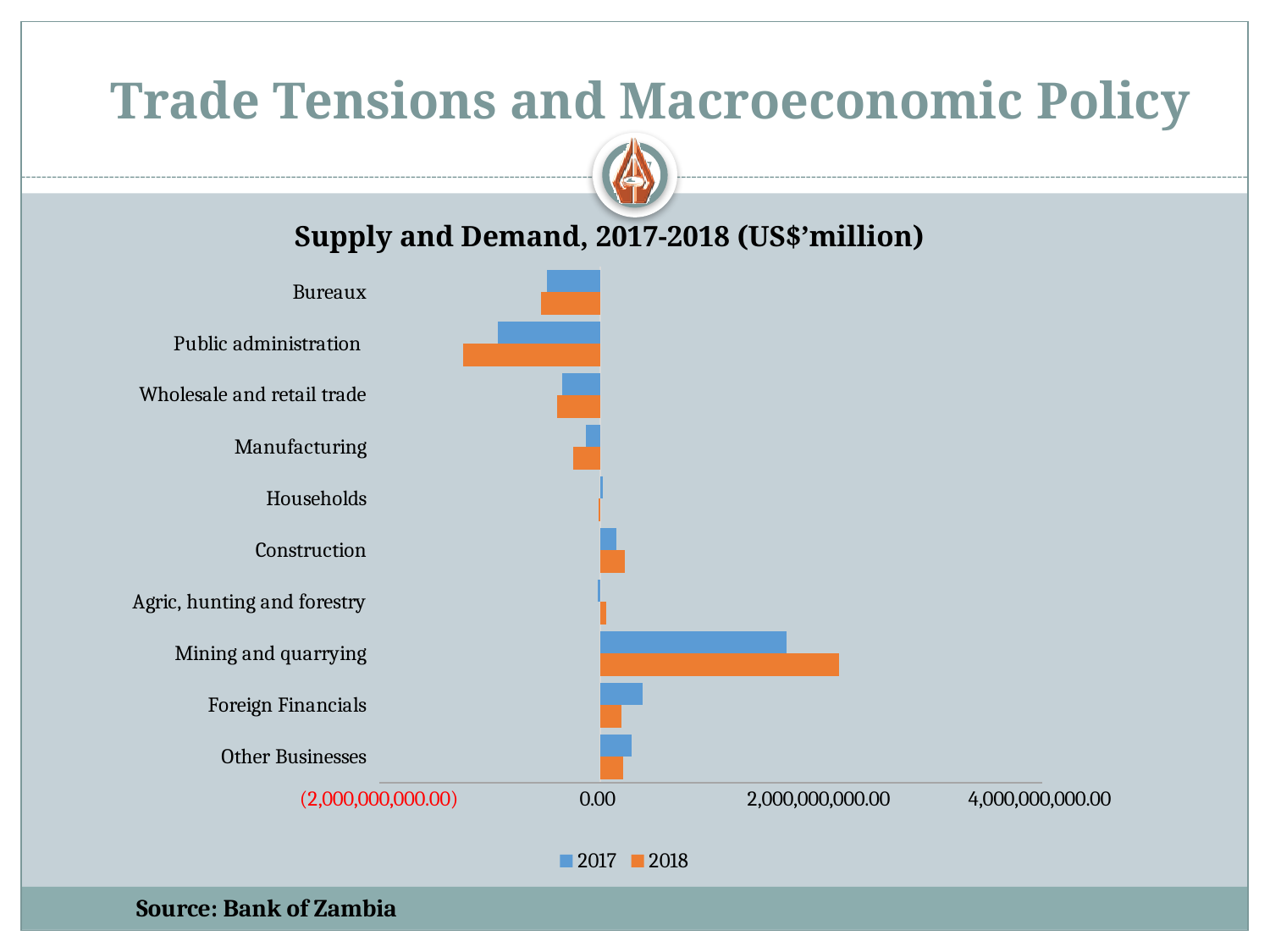
Is the 2018 value for Mining and quarrying greater or less than 2,000,000,000.00? greater What is the title of the chart? Supply and Demand, 2017-2018 (US$'million) How many categories are shown on the chart? 10 For Mining and quarrying, which year has the larger value, 2017 or 2018? 2018 Which category has the lowest (most negative) value for 2018? Public administration What kind of chart is shown on the slide? Bar chart How many series does the legend list? 2 Which category has the highest value for 2018? Mining and quarrying Is the 2017 value for Mining and quarrying greater or less than 2,000,000,000.00? less Which category has the highest value for 2017? Mining and quarrying Is the 2018 value for Public administration greater or less than 0.00? less For Foreign Financials, which year has the larger value, 2017 or 2018? 2017